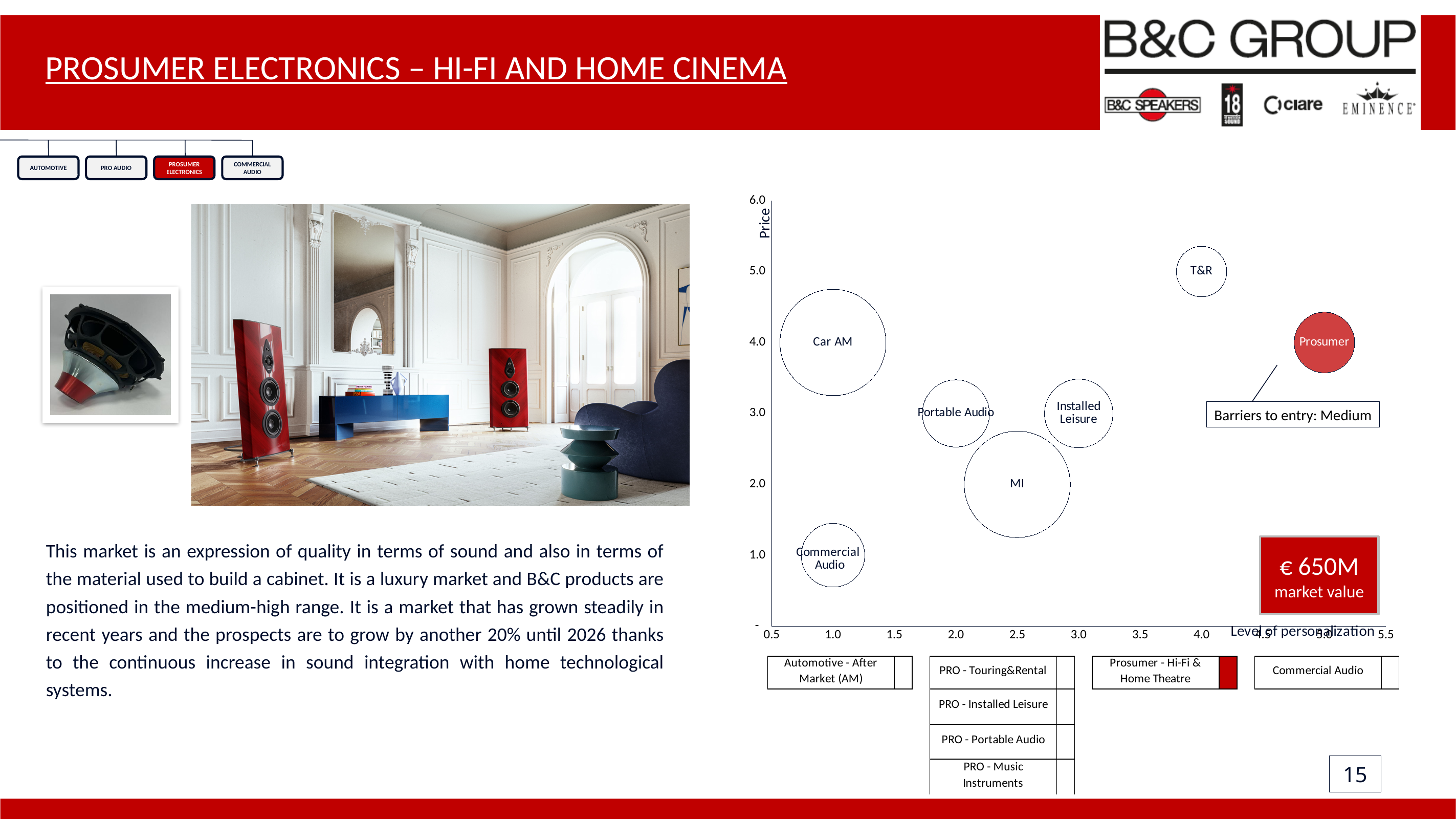
Which bubble has the highest level of personalization on the chart? Prosumer Is the price value for the MI bubble greater or less than 3.0? less Which has a higher level of personalization on the chart, Installed Leisure or Car AM? Installed Leisure Which has a higher price on the chart, Prosumer or MI? Prosumer What kind of chart is shown on the right of the slide? bubble chart Is the price value for the Car AM bubble greater or less than 3.0? greater What is the label of the vertical axis of the chart? Price How many bubbles are plotted on the chart? 7 Which bubble has the lowest price on the chart? Commercial Audio Which bubble has the highest price on the chart? T&R What level of barriers to entry is indicated for the Prosumer bubble? Medium Is the level of personalization for the T&R bubble greater or less than 3.5? greater